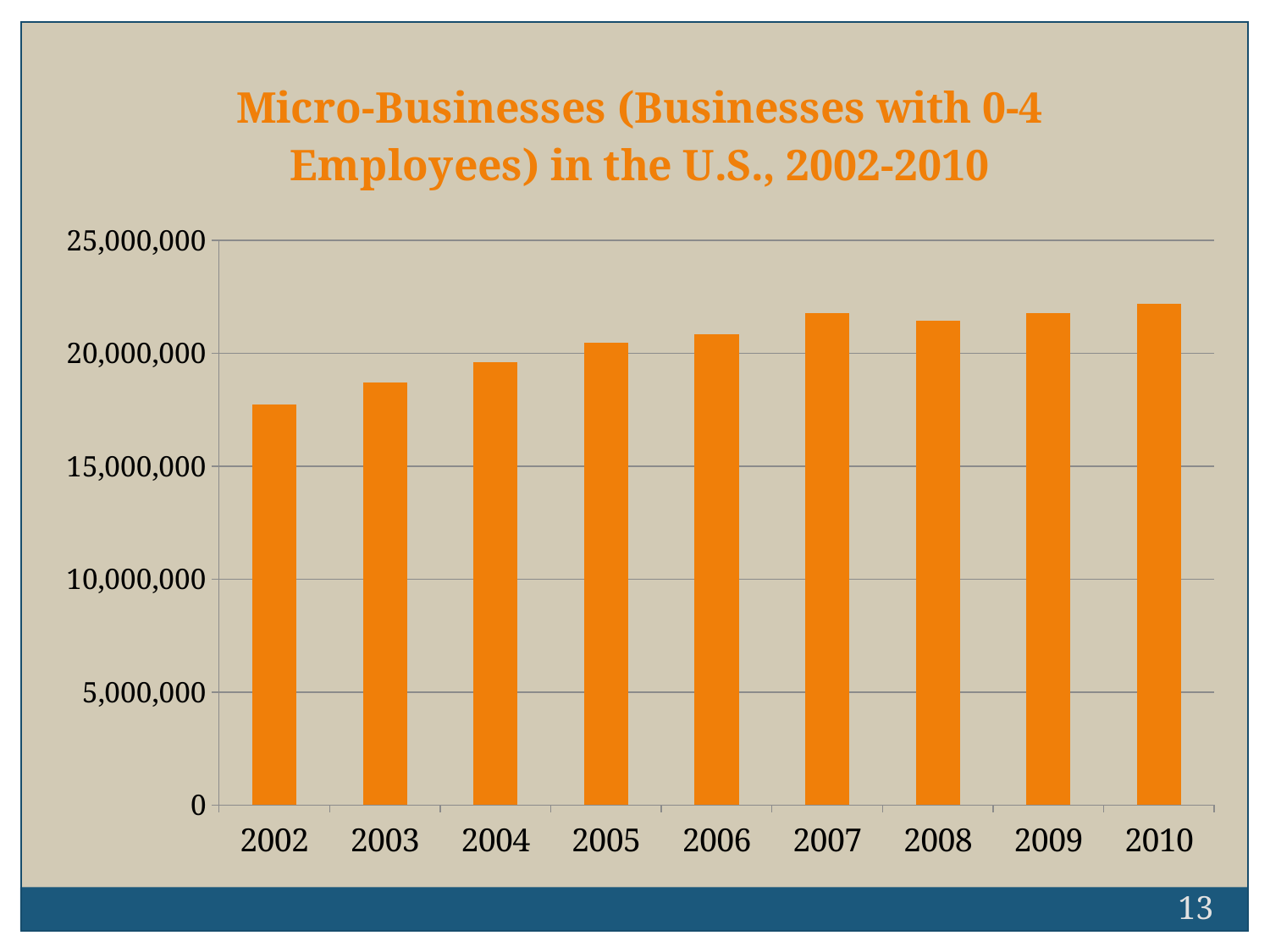
Which year has the highest number of micro-businesses? 2010 Which is larger, the value for 2002 or the value for 2006? 2006 Is the value for 2002 greater or less than 20,000,000? less Which is larger, the value for 2003 or the value for 2004? 2004 What is the title of the chart? Micro-Businesses (Businesses with 0-4 Employees) in the U.S., 2002-2010 Which year has the lowest number of micro-businesses? 2002 Is the value for 2004 greater or less than 20,000,000? less Overall, do the values rise or fall from 2002 to 2010? Rise How many years are plotted on the chart? 9 Is the value for 2010 greater or less than 25,000,000? less What kind of chart is shown on the slide? Bar chart